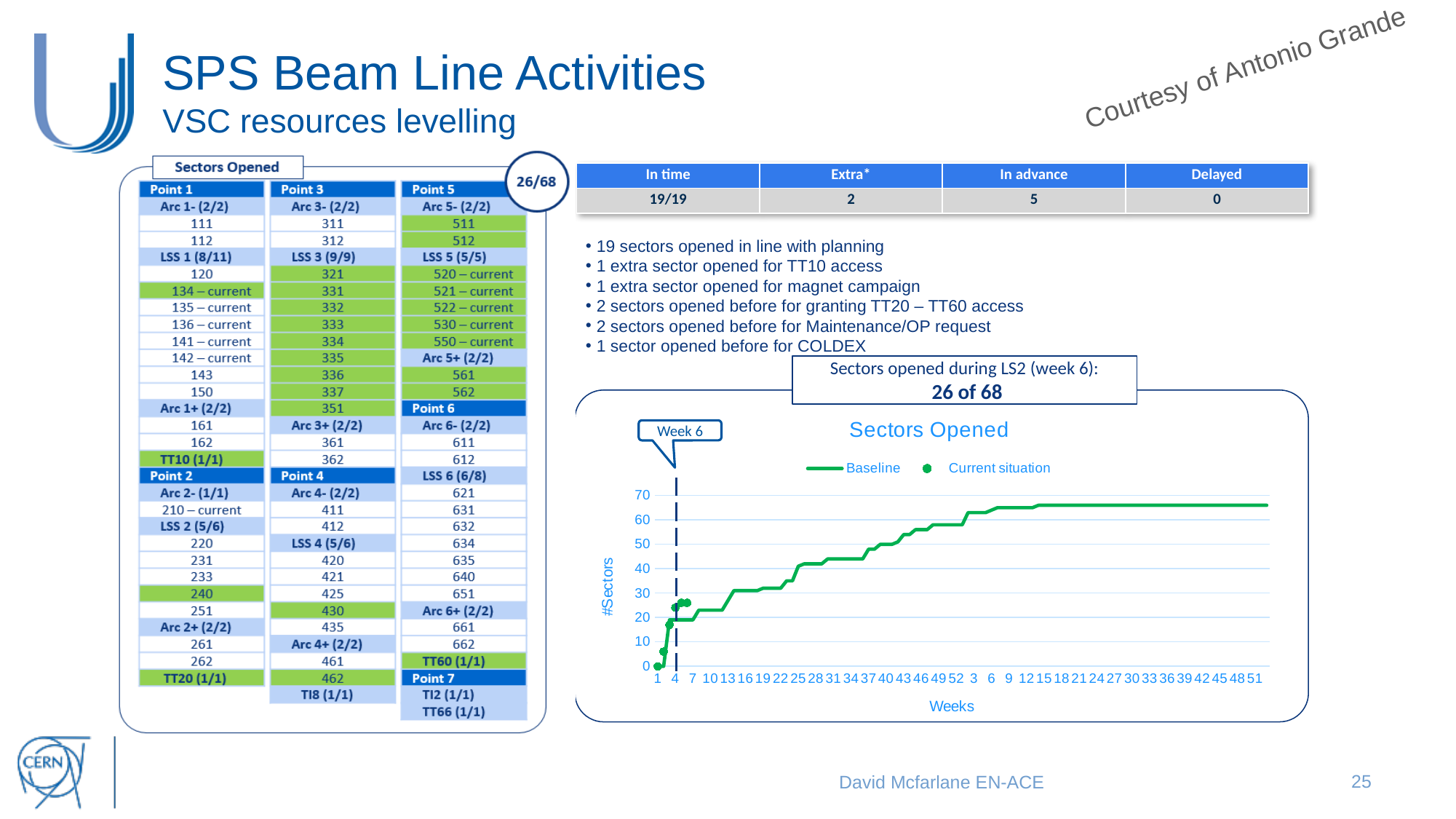
In the "Sectors Opened" chart, is the Baseline value at week 6 greater or less than 30? less What kind of chart is the "Sectors Opened" chart? line chart How many series does the legend of the "Sectors Opened" chart list? 2 What are the two series named in the legend of the "Sectors Opened" chart? Baseline and Current situation In the "Sectors Opened" chart, at week 6, which is larger: the Baseline value or the Current situation value? Current situation In the "Sectors Opened" chart, is the Baseline value at week 31 greater or less than 40? greater Does the Baseline series in the "Sectors Opened" chart rise or fall along the x axis? rise What is the highest tick value shown on the vertical axis of the "Sectors Opened" chart? 70 In the "Sectors Opened" chart, is the Current situation value at week 6 greater or less than 20? greater What is the label of the vertical axis of the "Sectors Opened" chart? #Sectors